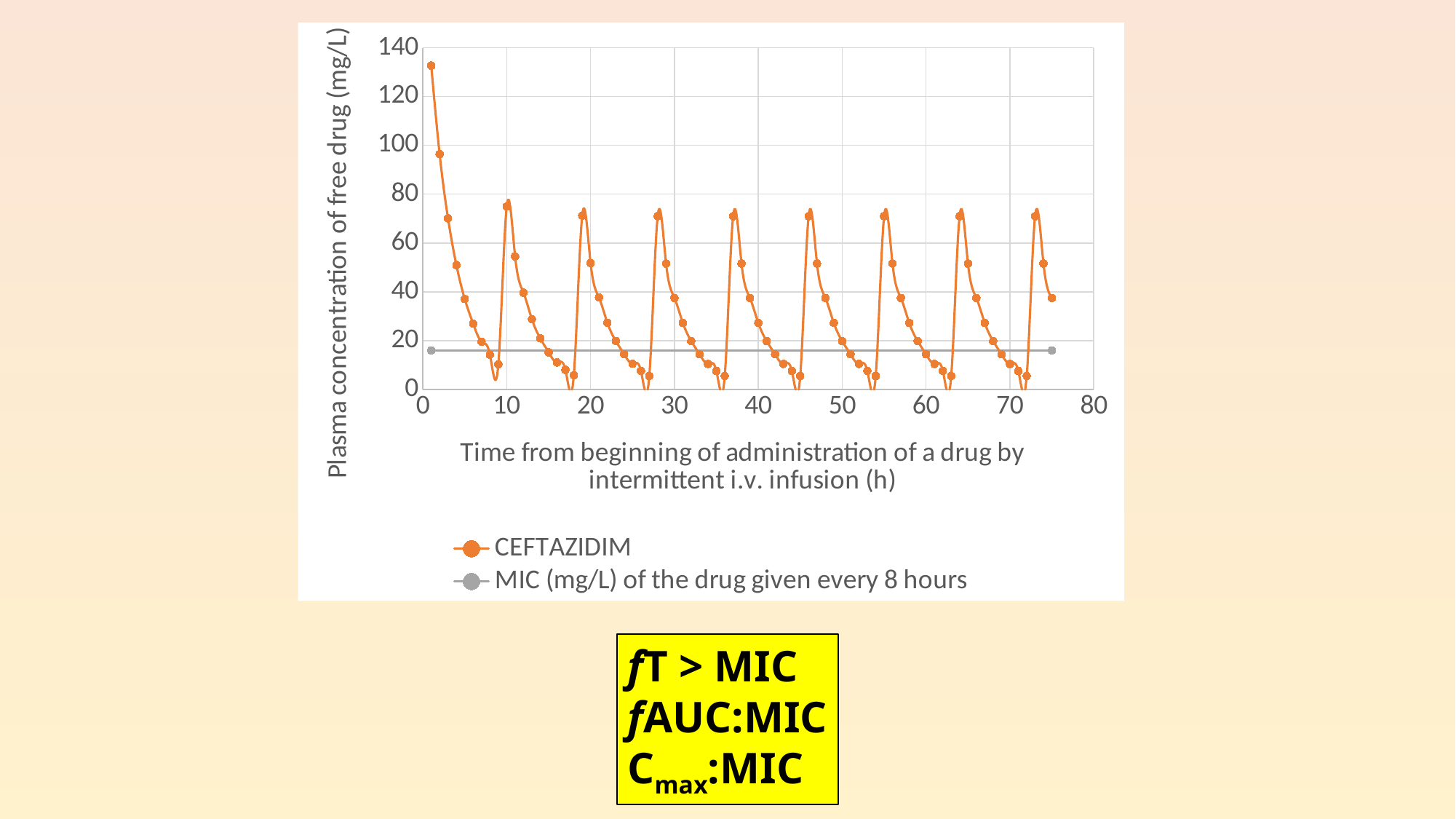
Which is larger, the CEFTAZIDIM value at time 1 h or the MIC line value? the CEFTAZIDIM value at time 1 h How many series does the legend list? 2 What kind of chart is shown on the slide? line chart What is the highest value shown on the y axis? 140 Is the first CEFTAZIDIM value (at time 1 h) greater or less than 120? greater What is the name of the orange series in the legend? CEFTAZIDIM Is the CEFTAZIDIM peak near 10 h greater or less than 100? less Is the CEFTAZIDIM peak near 10 h greater or less than 60? greater Between 1 h and 8 h, does the CEFTAZIDIM concentration rise or fall? fall Which is larger, the CEFTAZIDIM value at time 1 h or the CEFTAZIDIM peak near 10 h? the value at time 1 h What is the label of the y axis? Plasma concentration of free drug (mg/L)